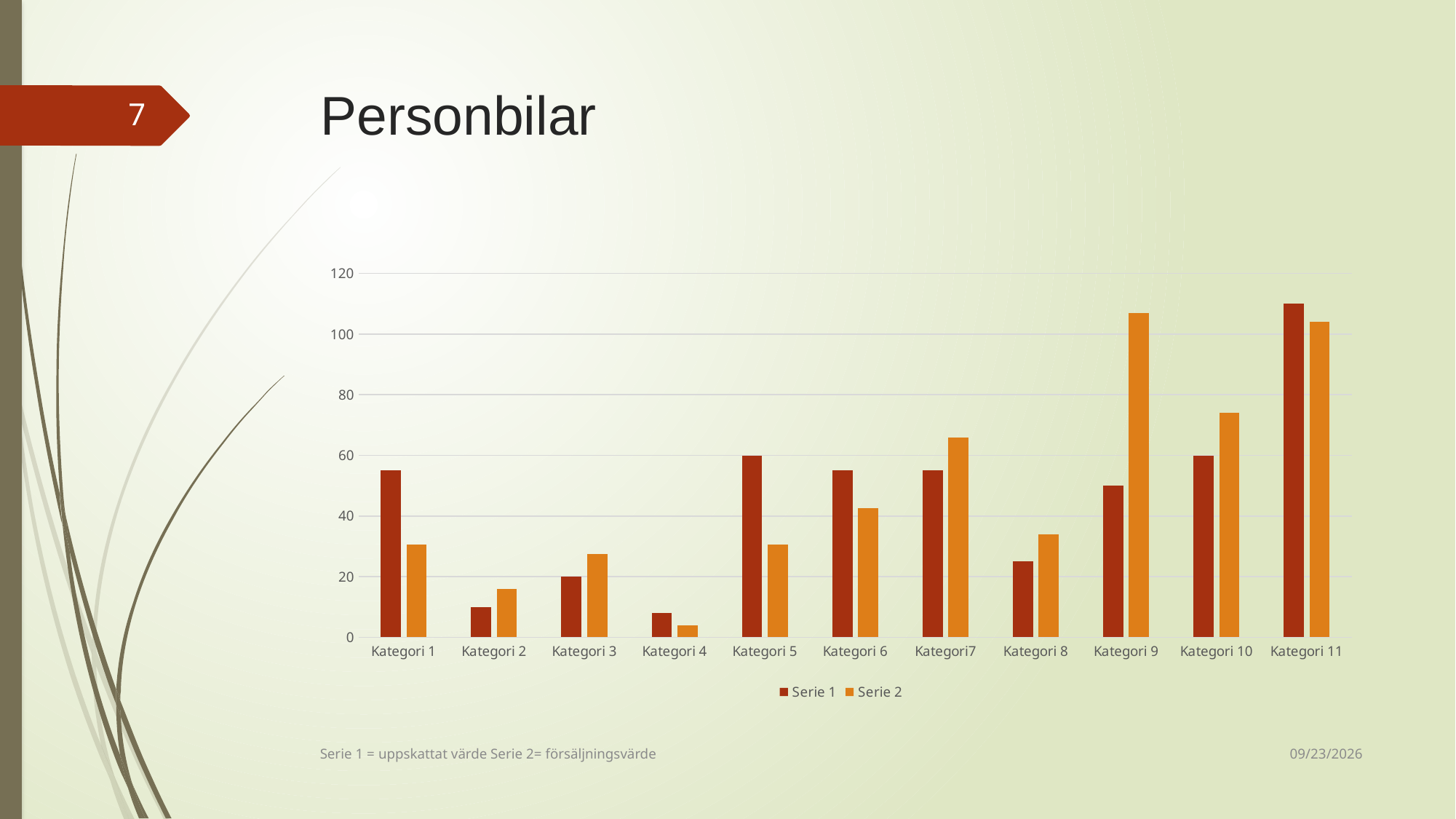
Is the Serie 2 value for Kategori 9 greater or less than 100? greater Is the Serie 1 value for Kategori 2 greater or less than 20? less Which category has the lowest value for Serie 1? Kategori 4 How many series does the chart's legend list? 2 For Kategori 1, which series has the larger value, Serie 1 or Serie 2? Serie 1 Which category has the highest value for Serie 2? Kategori 9 What kind of chart is shown on the slide? bar chart For Kategori 9, which series has the larger value, Serie 1 or Serie 2? Serie 2 How many categories are shown on the x axis of the chart? 11 Which category has the lowest value for Serie 2? Kategori 4 What is the title of the slide containing the chart? Personbilar Which category has the highest value for Serie 1? Kategori 11